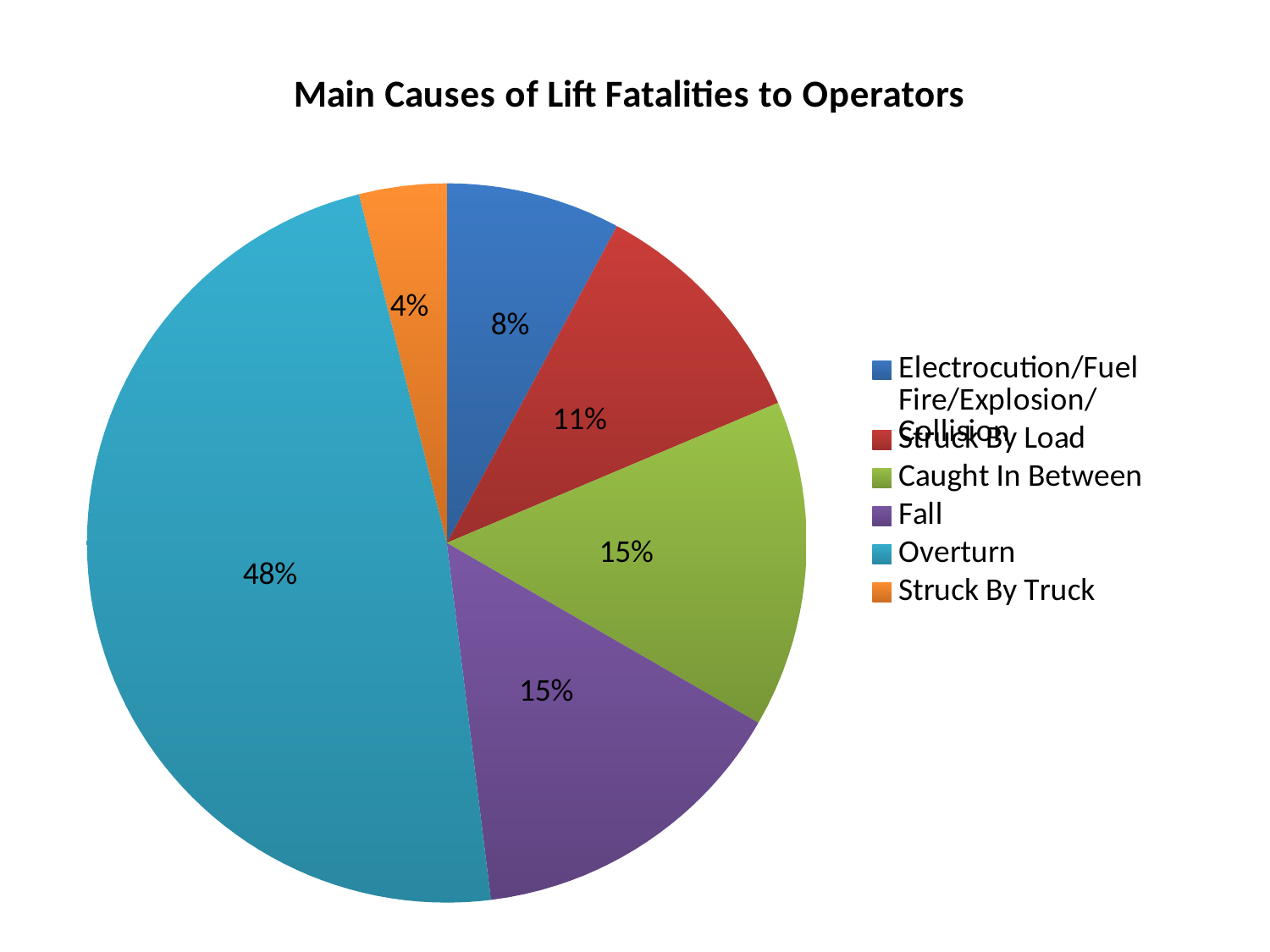
What kind of chart is shown on the slide? pie chart What percentage is shown for Struck By Truck? 4% What percentage is shown for Caught In Between? 15% Which is larger, the share for Struck By Load or the share for Struck By Truck? Struck By Load What percentage is shown for Fall? 15% What is the title of the chart? Main Causes of Lift Fatalities to Operators What is the difference in percentage points between Overturn and Fall? 33 How many categories does the legend list? 6 What percentage of lift fatalities to operators is attributed to Overturn? 48% Which cause accounts for the smallest share of the pie? Struck By Truck What percentage is shown for Struck By Load? 11% Which cause accounts for the largest share of the pie? Overturn